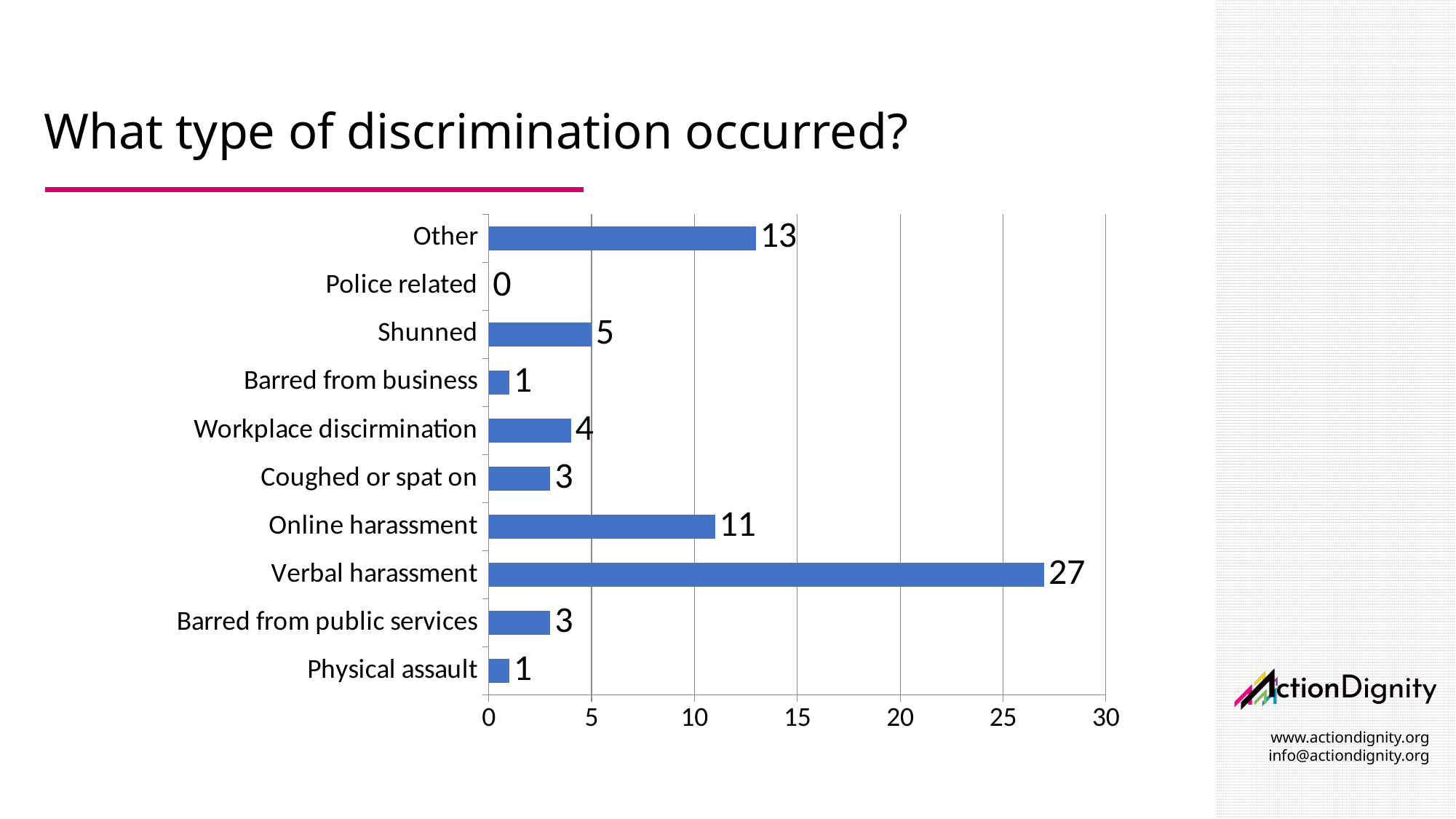
Which category has the highest value? Verbal harassment Is the value for Verbal harassment greater or less than 25? greater What is the value for Online harassment? 11 What is the difference between the values for Verbal harassment and Online harassment? 16 What kind of chart is shown on the slide? bar chart Which is larger, the value for Other or the value for Online harassment? Other What is the title of the slide? What type of discrimination occurred? How many categories are shown in the chart? 10 What is the value for Verbal harassment? 27 What is the value for Shunned? 5 What is the value for Police related? 0 Which category has the lowest value? Police related